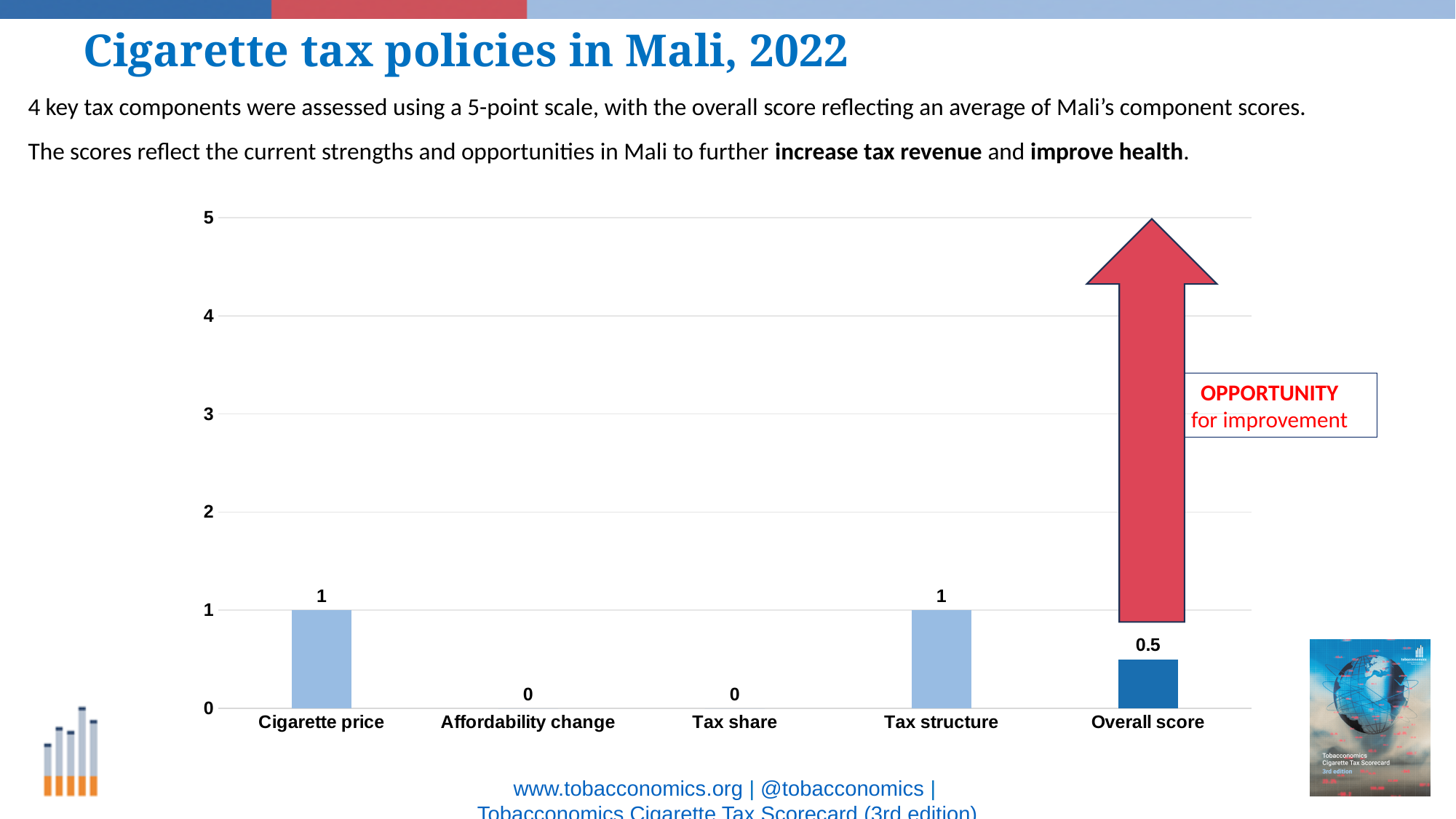
What is the value for Affordability change? 0 How many categories are shown on the x axis? 5 What is the value for Cigarette price? 1 Which category has the lowest value, Cigarette price or Tax share? Tax share What is the value for Tax structure? 1 What is the value for Tax share? 0 What text appears in the box next to the red arrow? OPPORTUNITY for improvement What is the maximum value shown on the y axis? 5 What kind of chart is shown on the slide? bar chart Is the value for Overall score greater or less than 1? less What is the Overall score? 0.5 What is the difference between the value for Cigarette price and the Overall score? 0.5